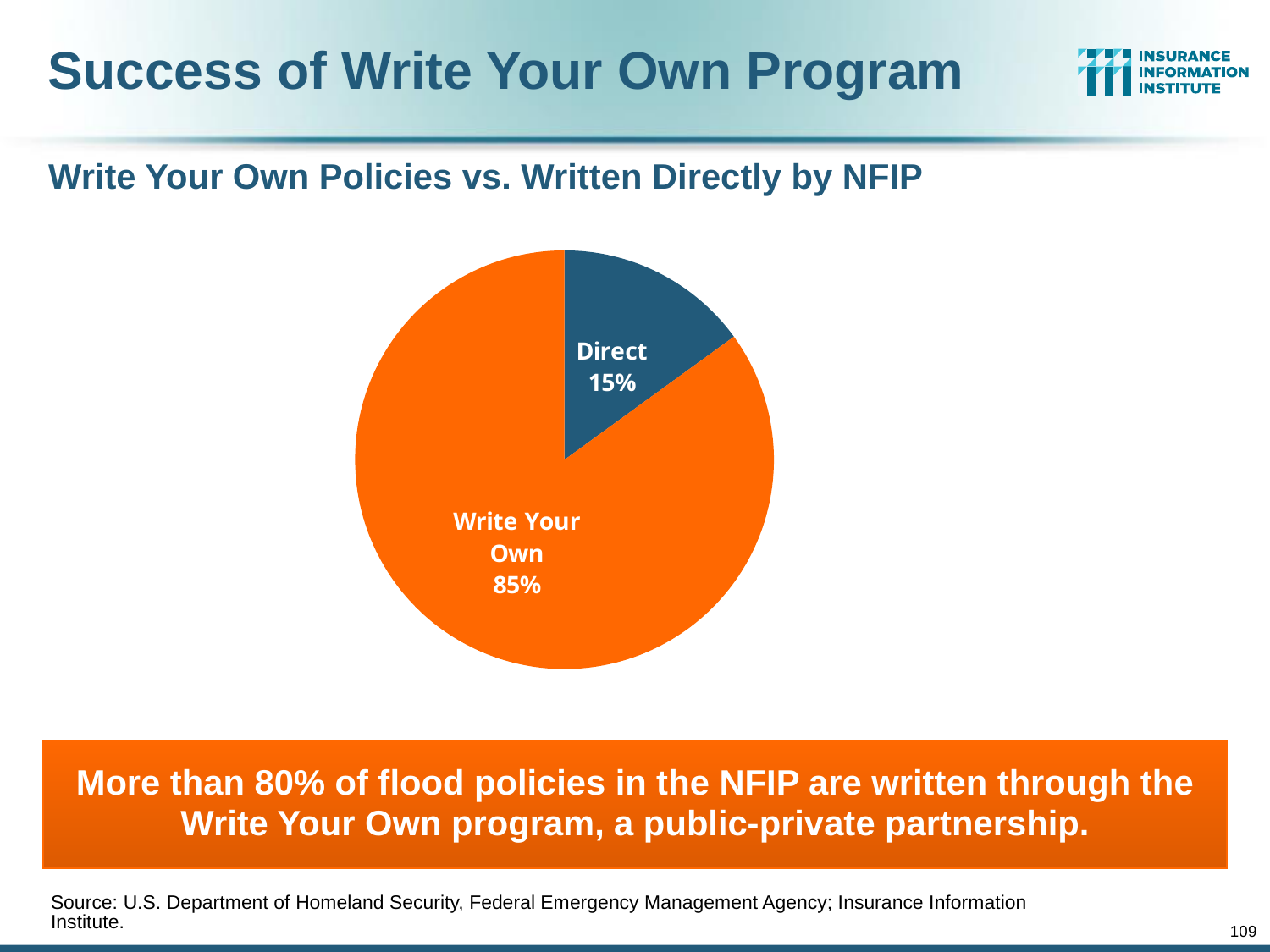
Which is larger, the Write Your Own slice or the Direct slice? Write Your Own Which slice of the pie is the largest? Write Your Own What share of the pie does the Direct slice represent? 15% What share of the pie does the Write Your Own slice represent? 85% What is the difference in percentage points between the Write Your Own slice and the Direct slice? 70 What kind of chart is shown on the slide? pie chart Which slice of the pie is the smallest? Direct How many slices does the pie chart have? 2 What is the title of the chart? Write Your Own Policies vs. Written Directly by NFIP What is the total of the two slices shown in the pie chart? 100% What colour is the Direct slice of the pie? dark blue